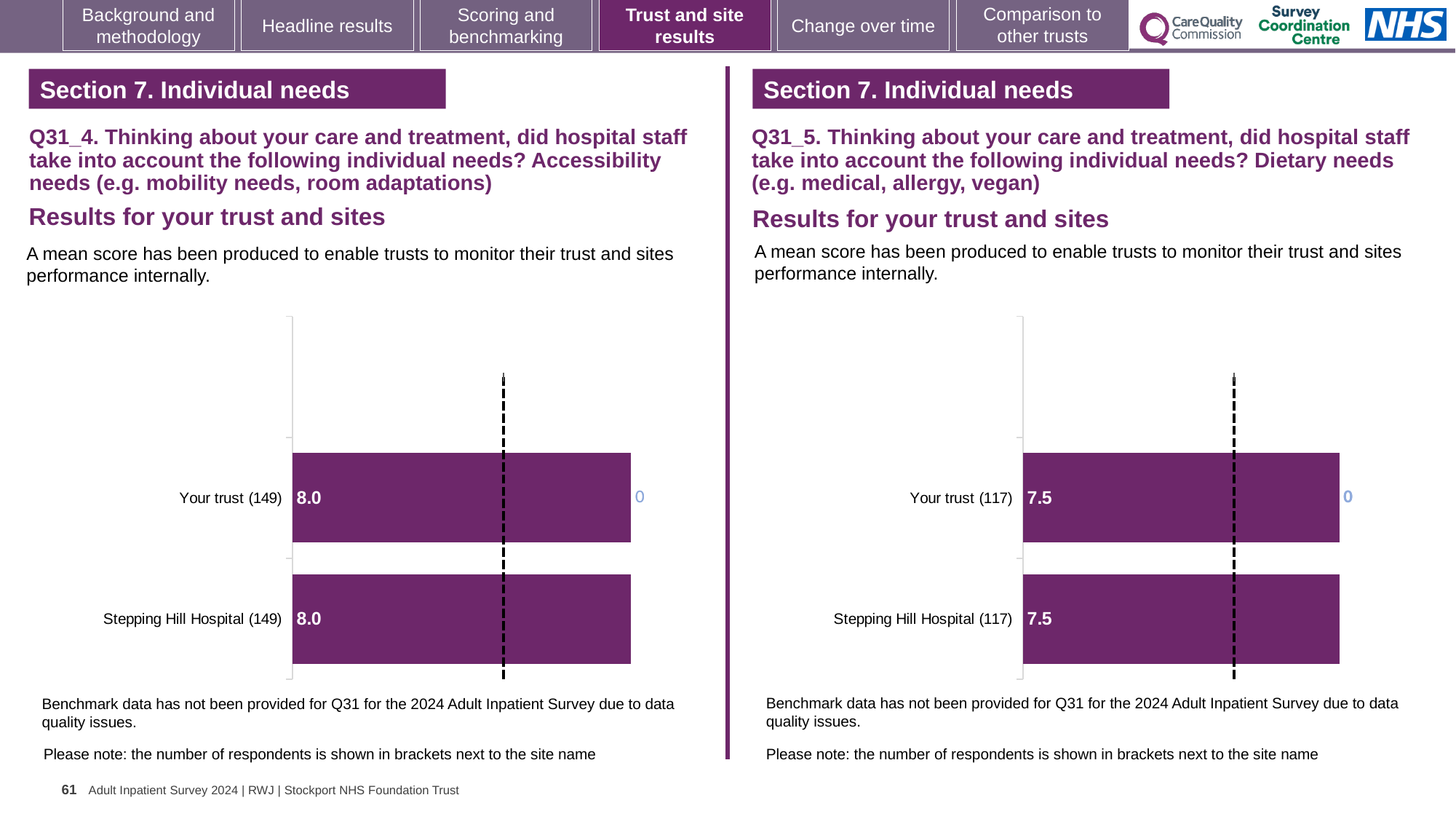
Is the Your trust score on the right chart (Q31_5, dietary needs) larger or smaller than the Your trust score on the left chart (Q31_4, accessibility needs)? Smaller On the right chart (Q31_5, dietary needs), what is the mean score for Your trust? 7.5 On the left chart (Q31_4, accessibility needs), what is the mean score for Stepping Hill Hospital? 8.0 How many bars are plotted on the right chart (Q31_5, dietary needs)? 2 What kind of chart is used on the left (Q31_4, accessibility needs)? Bar chart On the right chart (Q31_5, dietary needs), how many respondents are shown in brackets next to Stepping Hill Hospital? 117 On the right chart (Q31_5, dietary needs), what is the difference between the scores for Your trust and Stepping Hill Hospital? 0.0 On the left chart (Q31_4, accessibility needs), what is the mean score for Your trust? 8.0 On the left chart (Q31_4, accessibility needs), how many respondents are shown in brackets next to Your trust? 149 How many bars are plotted on the left chart (Q31_4, accessibility needs)? 2 On the right chart (Q31_5, dietary needs), what is the mean score for Stepping Hill Hospital? 7.5 On the left chart (Q31_4, accessibility needs), what is the difference between the scores for Your trust and Stepping Hill Hospital? 0.0